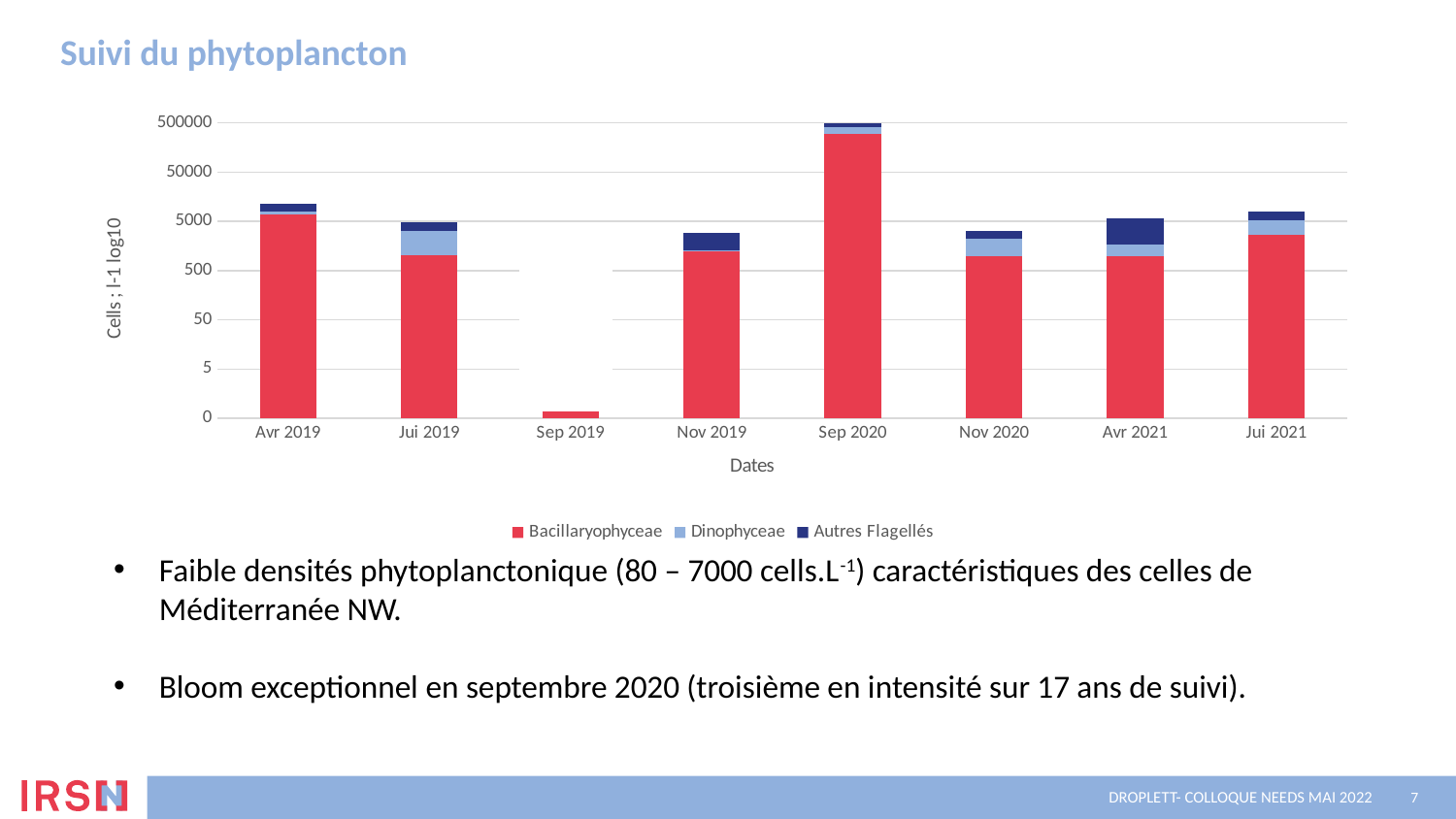
How many dates (categories) are shown on the x axis of the chart? 8 Is the total value for Jui 2021 greater or less than 5000? greater Which has the larger total bar, Sep 2020 or Avr 2019? Sep 2020 Which has the larger total bar, Sep 2019 or Nov 2019? Nov 2019 Is the total value for Nov 2019 greater or less than 5000? less Is the total value for Sep 2020 greater or less than 50000? greater How many series does the chart legend list? 3 What kind of chart is shown on the slide? Stacked bar chart Which series is shown in red in the chart legend? Bacillaryophyceae Which date has the lowest total bar in the chart? Sep 2019 Which date has the highest total bar in the chart? Sep 2020 What is the title of the chart on the slide? Suivi du phytoplancton